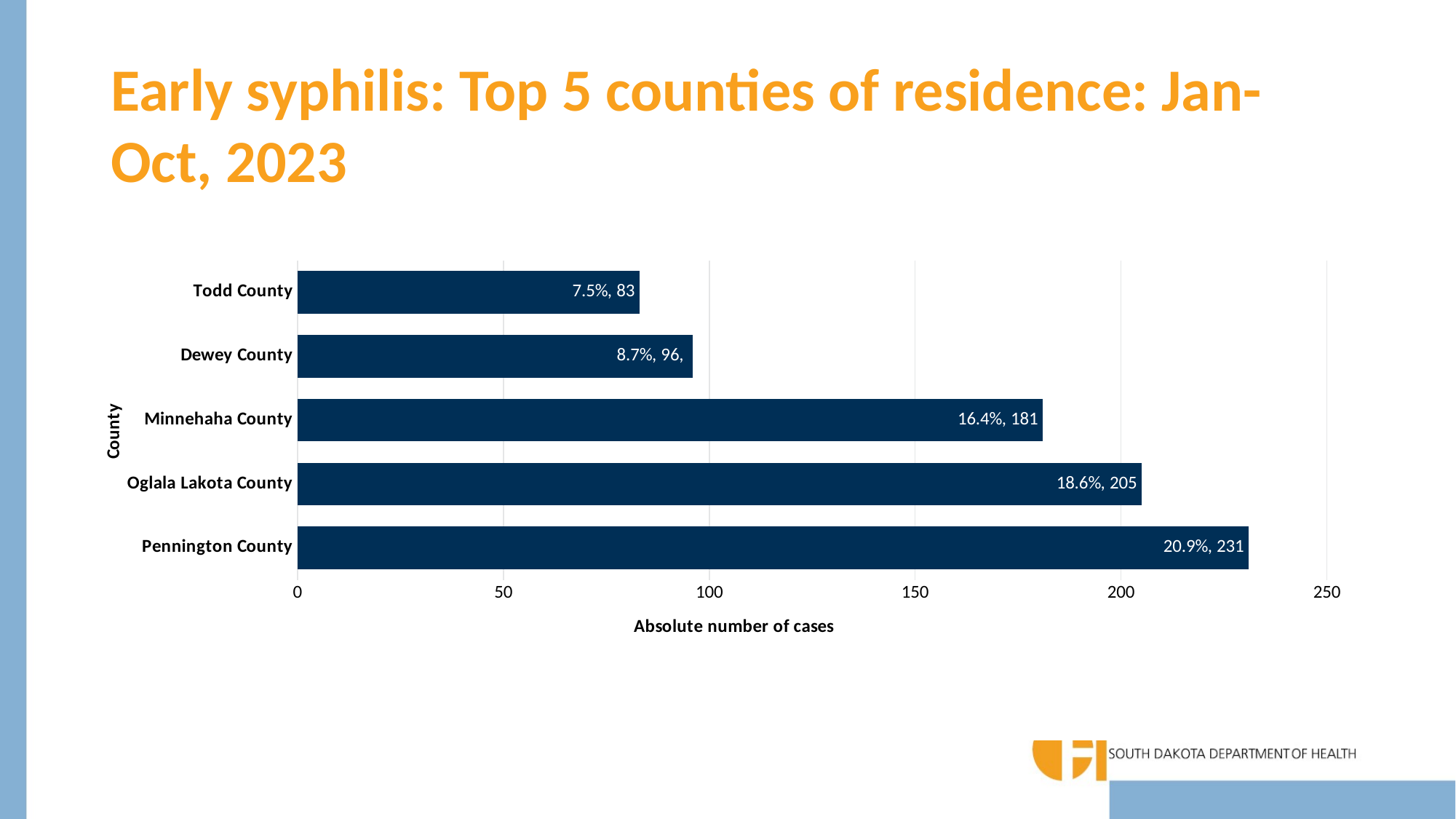
What is the label of the horizontal axis? Absolute number of cases Is the value for Minnehaha County greater or less than 150? greater What kind of chart is shown on the slide? Bar chart Which county has the lowest number of early syphilis cases? Todd County What is the difference in cases between Dewey County and Todd County? 13 How many counties are shown in the chart? 5 Which county has the highest number of early syphilis cases? Pennington County How many early syphilis cases were reported for Pennington County? 231 What percentage of early syphilis cases is attributed to Minnehaha County? 16.4% How many cases are shown for Dewey County? 96 Which county has more cases, Minnehaha County or Oglala Lakota County? Oglala Lakota County What is the difference in cases between Pennington County and Oglala Lakota County? 26